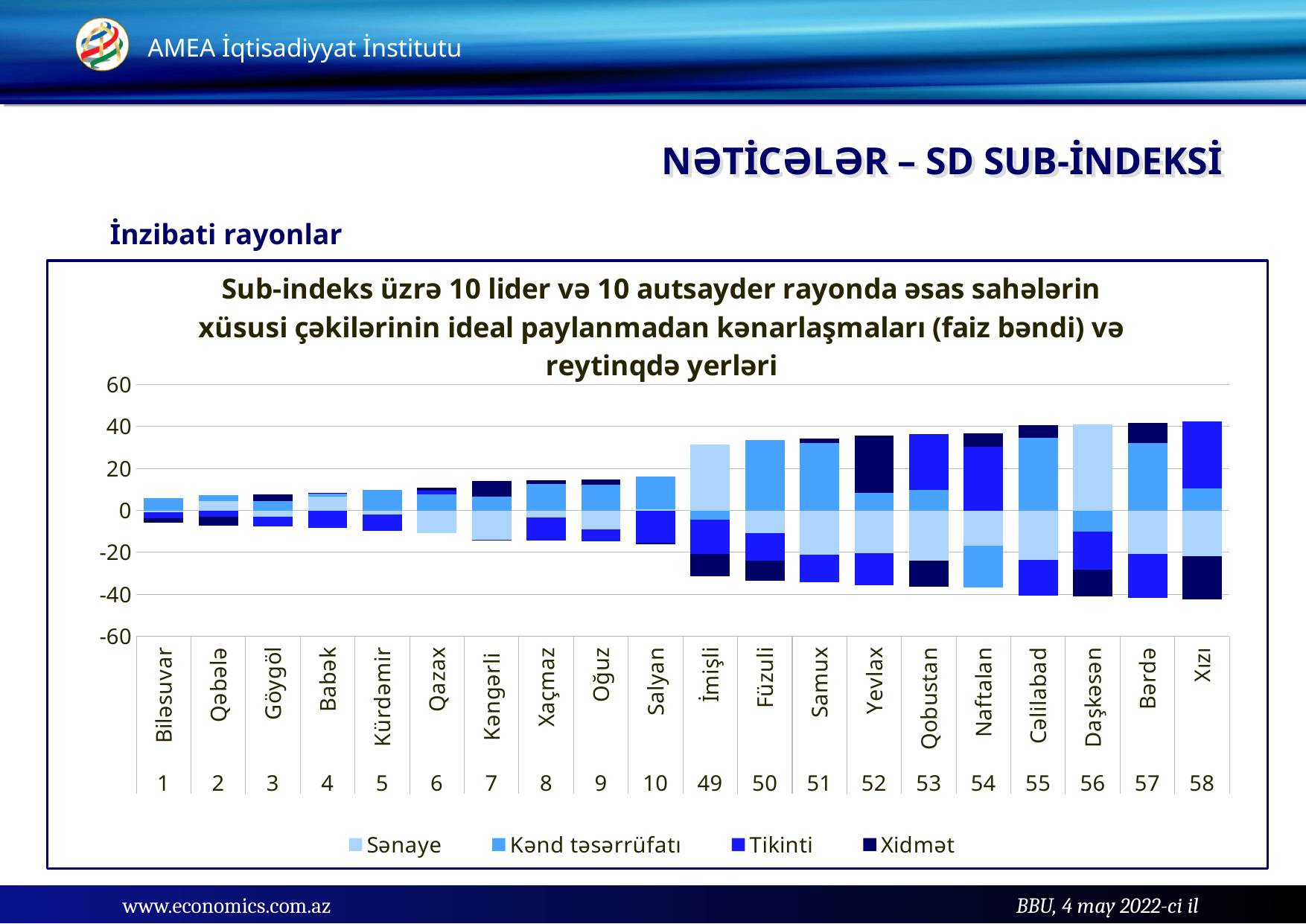
What kind of chart is shown on the slide? Stacked bar chart Which district has the larger positive stacked bar, Xızı or Biləsuvar? Xızı How many districts (categories) are shown on the x axis of the chart? 20 Which district is shown with rank 58 on the x axis? Xızı What is the highest value shown on the vertical axis of the chart? 60 Which district is shown with rank 1 on the x axis? Biləsuvar Is the top of the positive stacked bar for Xızı greater or less than 40? greater What are the four series named in the chart legend? Sənaye, Kənd təsərrüfatı, Tikinti, Xidmət Is the top of the positive stacked bar for Salyan greater or less than 20? less How many series does the chart legend list? 4 Is the top of the positive stacked bar for Füzuli greater or less than 20? greater What rank number is shown under Qobustan on the x axis? 53